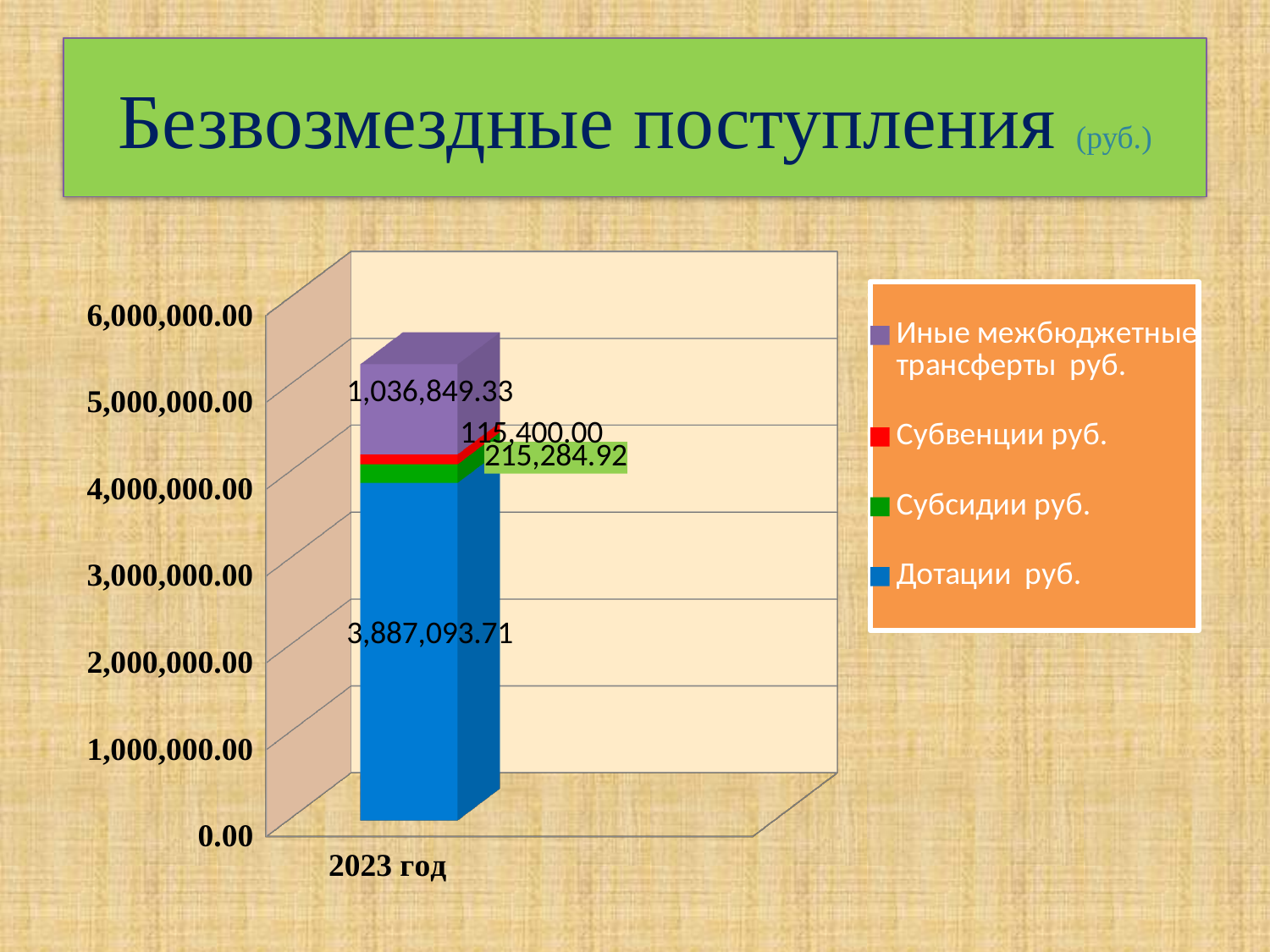
Which is larger in 2023 год: Субсидии руб. or Субвенции руб.? Субсидии руб. Which series has the lowest value in 2023 год? Субвенции руб. What is the value for Дотации руб. in 2023 год? 3,887,093.71 What is the value for Субвенции руб. in 2023 год? 115,400.00 What kind of chart is shown on the slide? Stacked bar chart What is the difference between Дотации руб. and Иные межбюджетные трансферты руб. in 2023 год? 2,850,244.38 Which series has the highest value in 2023 год? Дотации руб. What is the value for Иные межбюджетные трансферты руб. in 2023 год? 1,036,849.33 What is the total of the stacked bar for 2023 год? 5,254,627.96 What is the value for Субсидии руб. in 2023 год? 215,284.92 How many series does the legend list? 4 What is the difference between Субсидии руб. and Субвенции руб. in 2023 год? 99,884.92